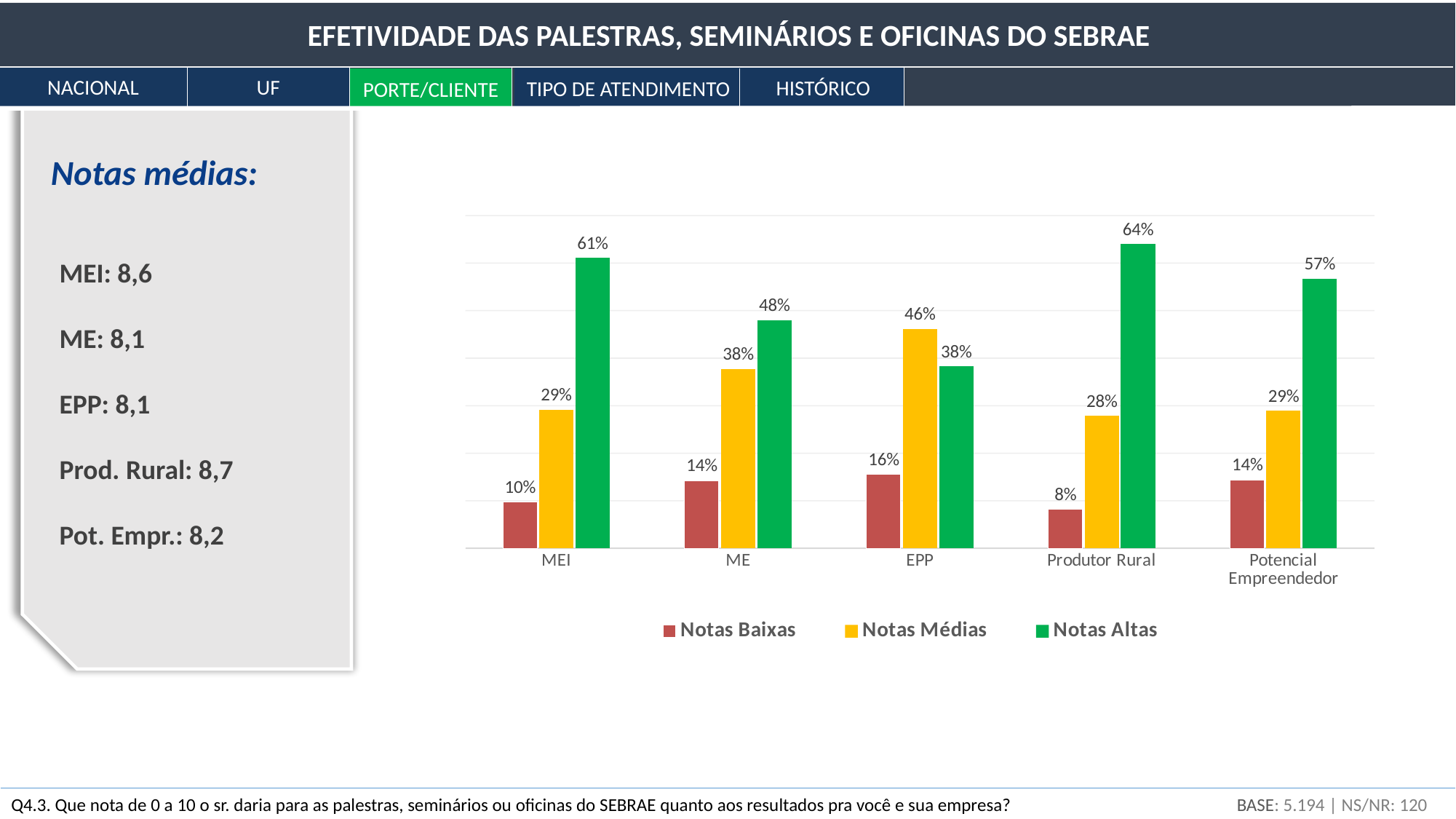
What kind of chart is shown? Bar chart What is the difference between Notas Altas and Notas Médias for Potencial Empreendedor? 28 percentage points What is the value of Notas Médias for EPP? 46% Which category has the lowest Notas Baixas value? Produtor Rural What is the value of Notas Altas for MEI? 61% How many categories are shown on the x axis? 5 What is the value of Notas Baixas for ME? 14% Which colour represents Notas Altas in the chart? Green What is the value of Notas Baixas for Produtor Rural? 8% For EPP, which is larger: Notas Médias or Notas Altas? Notas Médias Which category has the highest Notas Altas value? Produtor Rural How many series does the legend list? 3